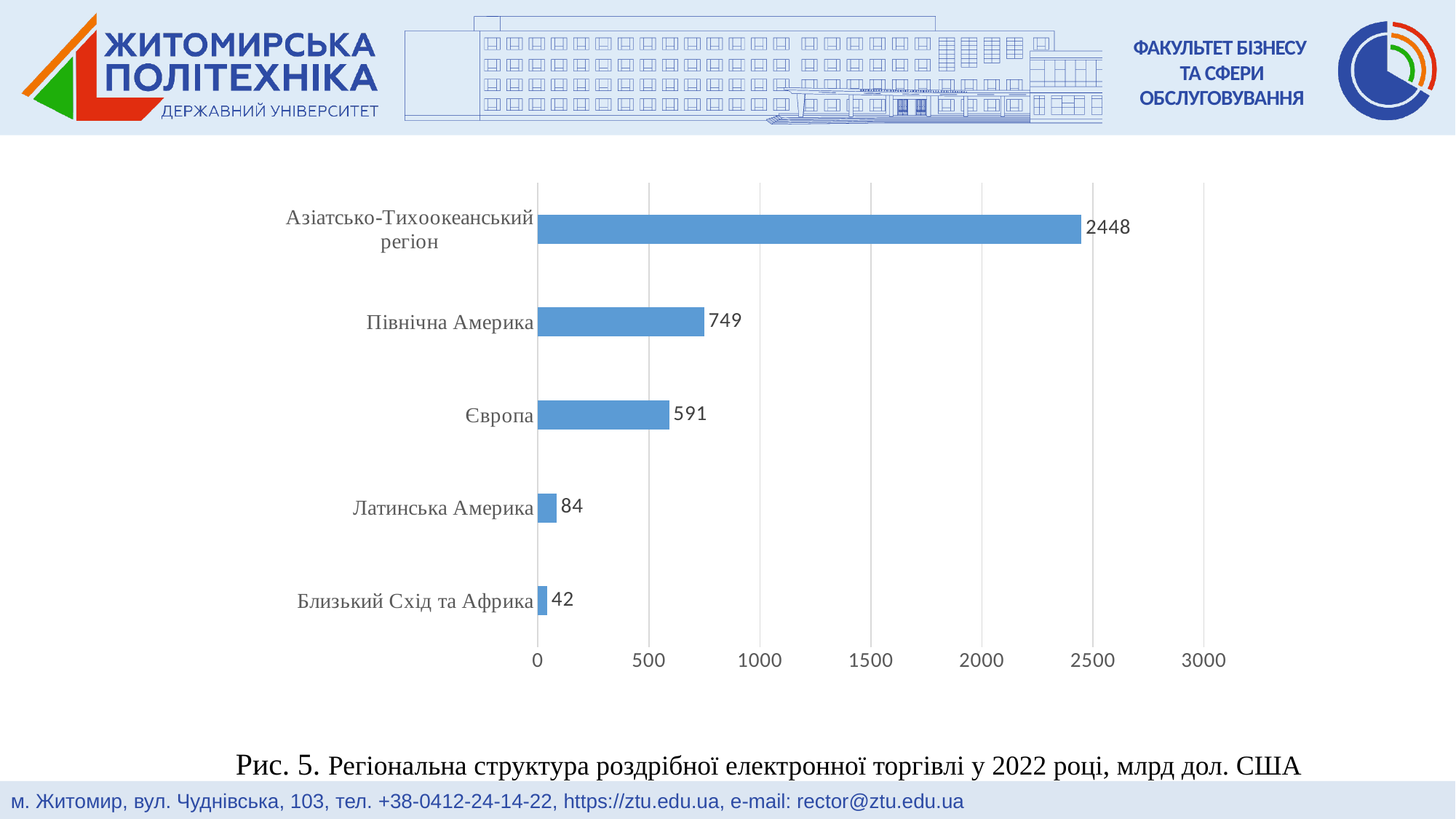
Which is larger, the value for Латинська Америка or the value for Близький Схід та Африка? Латинська Америка What is the value for Азіатсько-Тихоокеанський регіон? 2448 Which region has the lowest value? Близький Схід та Африка Which region has the highest value? Азіатсько-Тихоокеанський регіон Is the value for Азіатсько-Тихоокеанський регіон greater or less than 2000? greater What is the value for Європа? 591 How many regions are shown in the chart? 5 What is the difference between the values for Північна Америка and Європа? 158 What is the value for Північна Америка? 749 What kind of chart is shown on the slide? bar chart What is the value for Близький Схід та Африка? 42 What is the value for Латинська Америка? 84